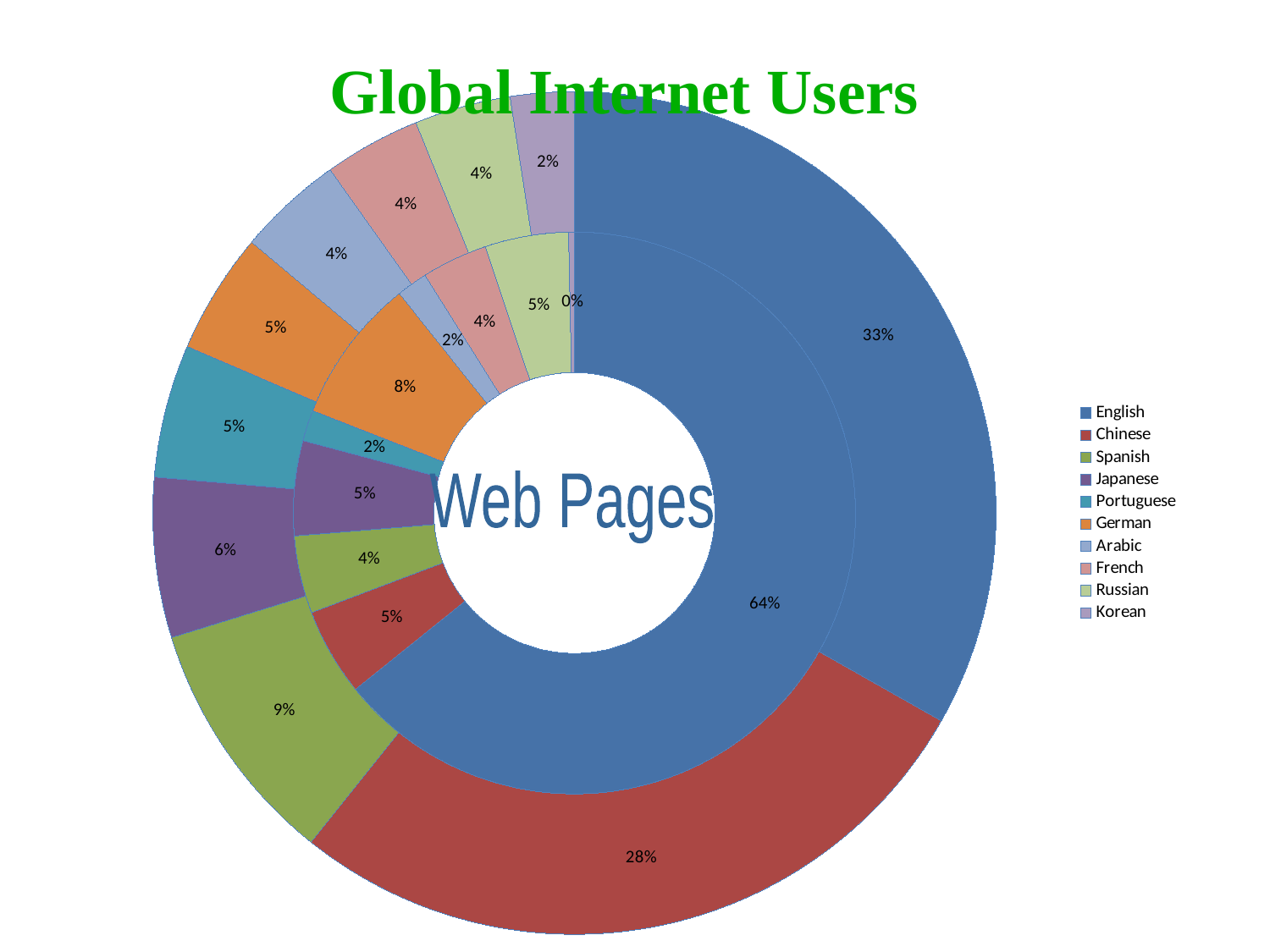
In the outer ring (Global Internet Users), what is the share for Chinese? 28% What label is printed in the centre of the doughnut chart? Web Pages In the outer ring (Global Internet Users), what is the share for Spanish? 9% In the outer ring (Global Internet Users), what is the share for English? 33% How many languages does the legend list? 10 What is the difference between the English and Chinese shares in the outer ring (Global Internet Users)? 5% In the inner ring (Web Pages), what is the share for German? 8% In the outer ring (Global Internet Users), which is larger, the share for Spanish or the share for Japanese? Spanish What kind of chart is shown on the slide? doughnut chart Which language has the largest share in the inner ring (Web Pages)? English In the inner ring (Web Pages), what is the share for English? 64% Which language has the smallest share in the outer ring (Global Internet Users)? Korean